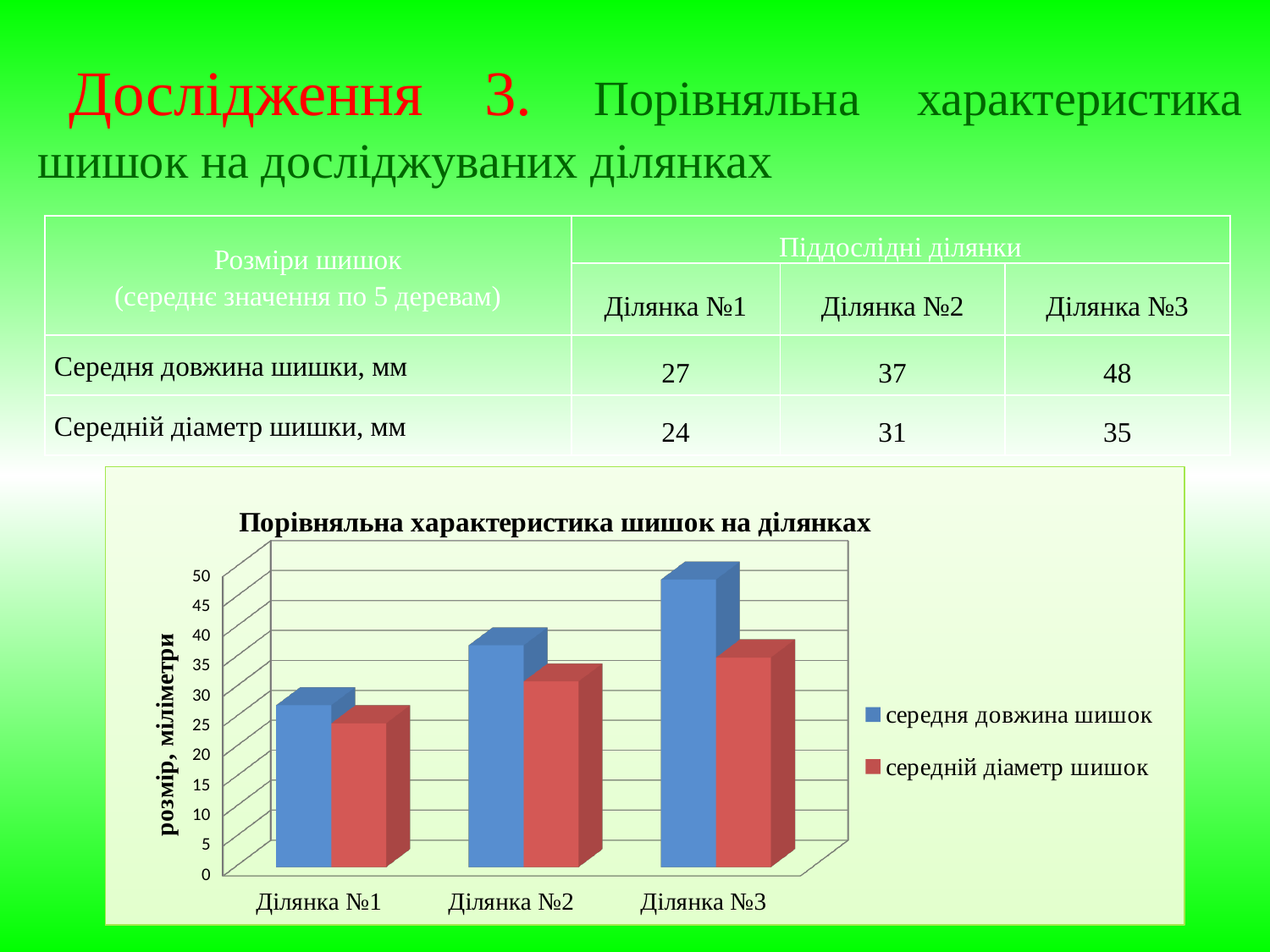
Which plot has the lowest value for 'середній діаметр шишок'? Ділянка №1 What is the value of 'середня довжина шишок' for Ділянка №2, as given in the table on the slide? 37 Which colour represents 'середня довжина шишок' in the chart? blue How many categories (plots) are shown on the x axis of the chart? 3 Do the values for 'середня довжина шишок' rise or fall from Ділянка №1 to Ділянка №3? rise How many series does the chart legend list? 2 What kind of chart is shown on the slide? bar chart What is the title of the chart? Порівняльна характеристика шишок на ділянках Which is larger at Ділянка №2: 'середня довжина шишок' or 'середній діаметр шишок'? середня довжина шишок Is the value for 'середня довжина шишок' at Ділянка №3 greater or less than 45? greater Which plot has the highest value for 'середня довжина шишок'? Ділянка №3